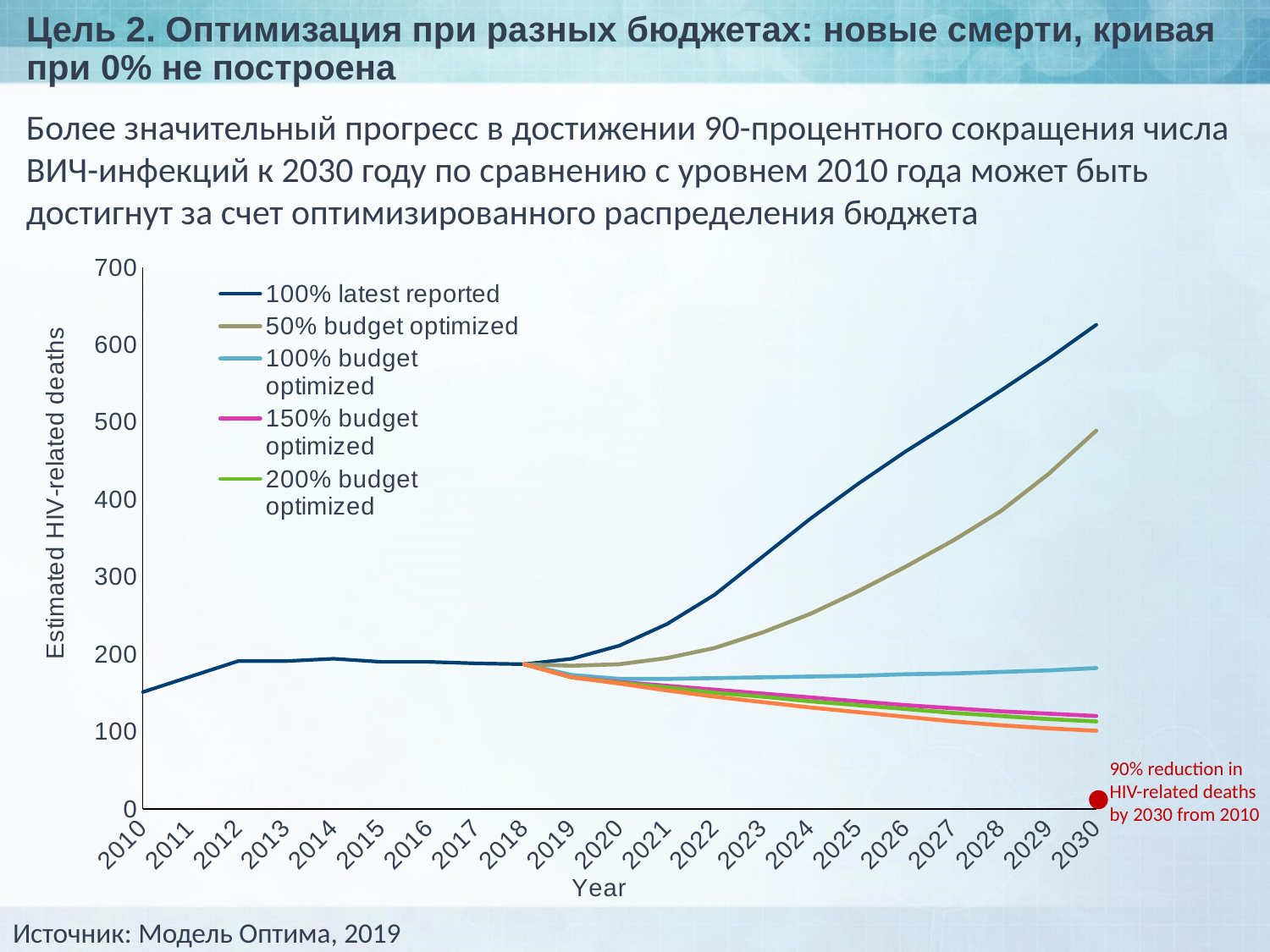
Does the '200% budget optimized' line rise or fall from 2018 to 2030? fall In 2030, which is larger: '100% latest reported' or '50% budget optimized'? 100% latest reported What is the title of the chart's vertical axis? Estimated HIV-related deaths How many series does the chart legend list? 5 Which series has the highest value in 2030? 100% latest reported How many years are shown along the x axis of the chart? 21 Is the value of the '100% latest reported' line in 2010 greater or less than 200? less What kind of chart is shown on the slide? line chart Is the value of the '50% budget optimized' line in 2030 greater or less than 400? greater Is the value of the '100% budget optimized' line in 2030 greater or less than 200? less Does the '100% latest reported' line rise or fall from 2018 to 2030? rise